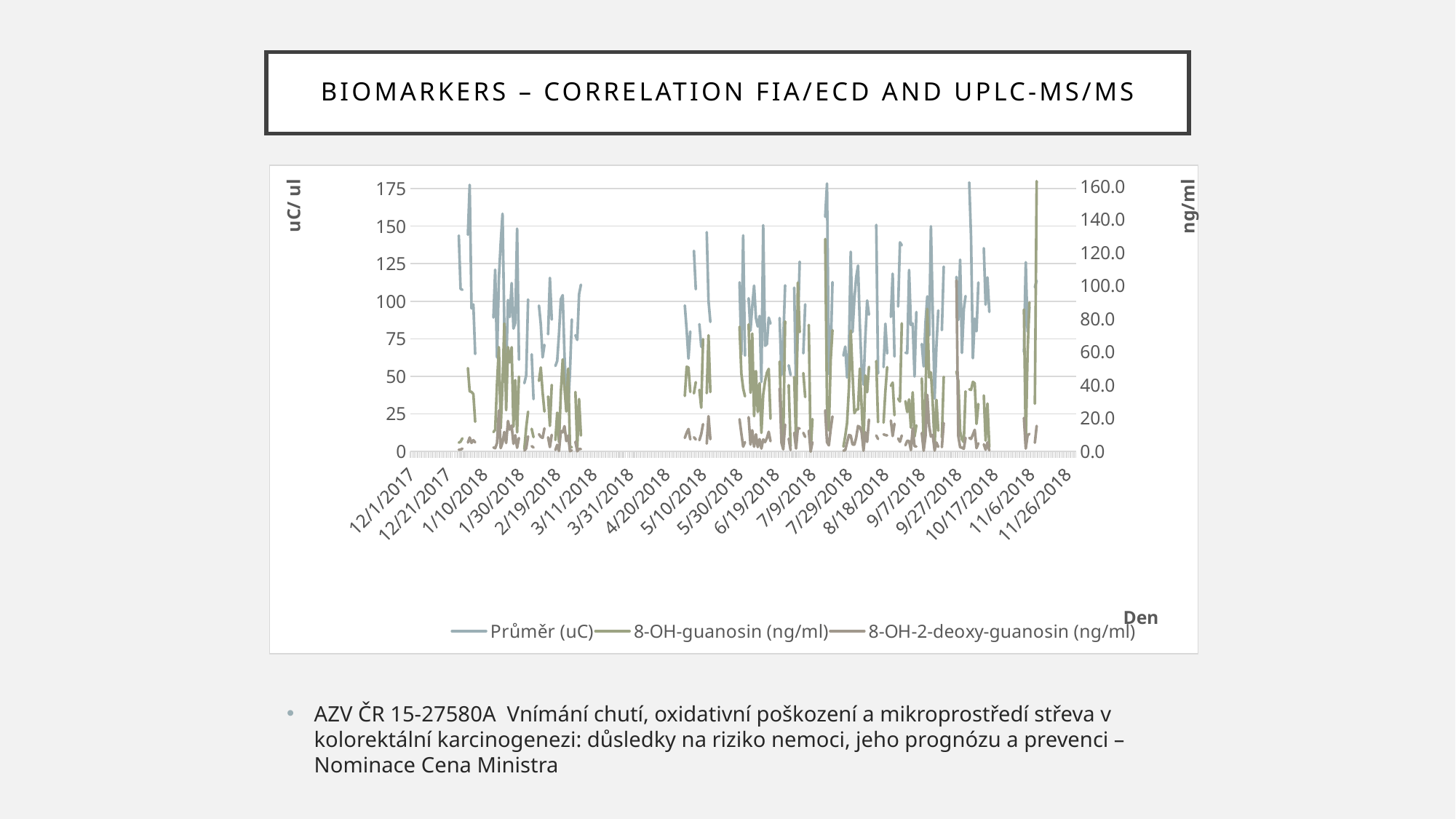
Which series has the lowest values overall on the chart? 8-OH-2-deoxy-guanosin (ng/ml) What kind of chart is shown on the slide? line chart How many series does the chart legend list? 3 Which series reaches higher peaks on the chart, Průměr (uC) or 8-OH-2-deoxy-guanosin (ng/ml)? Průměr (uC) What is the title of the left vertical axis of the chart? uC/ ul What are the three series named in the chart legend? Průměr (uC), 8-OH-guanosin (ng/ml), 8-OH-2-deoxy-guanosin (ng/ml)